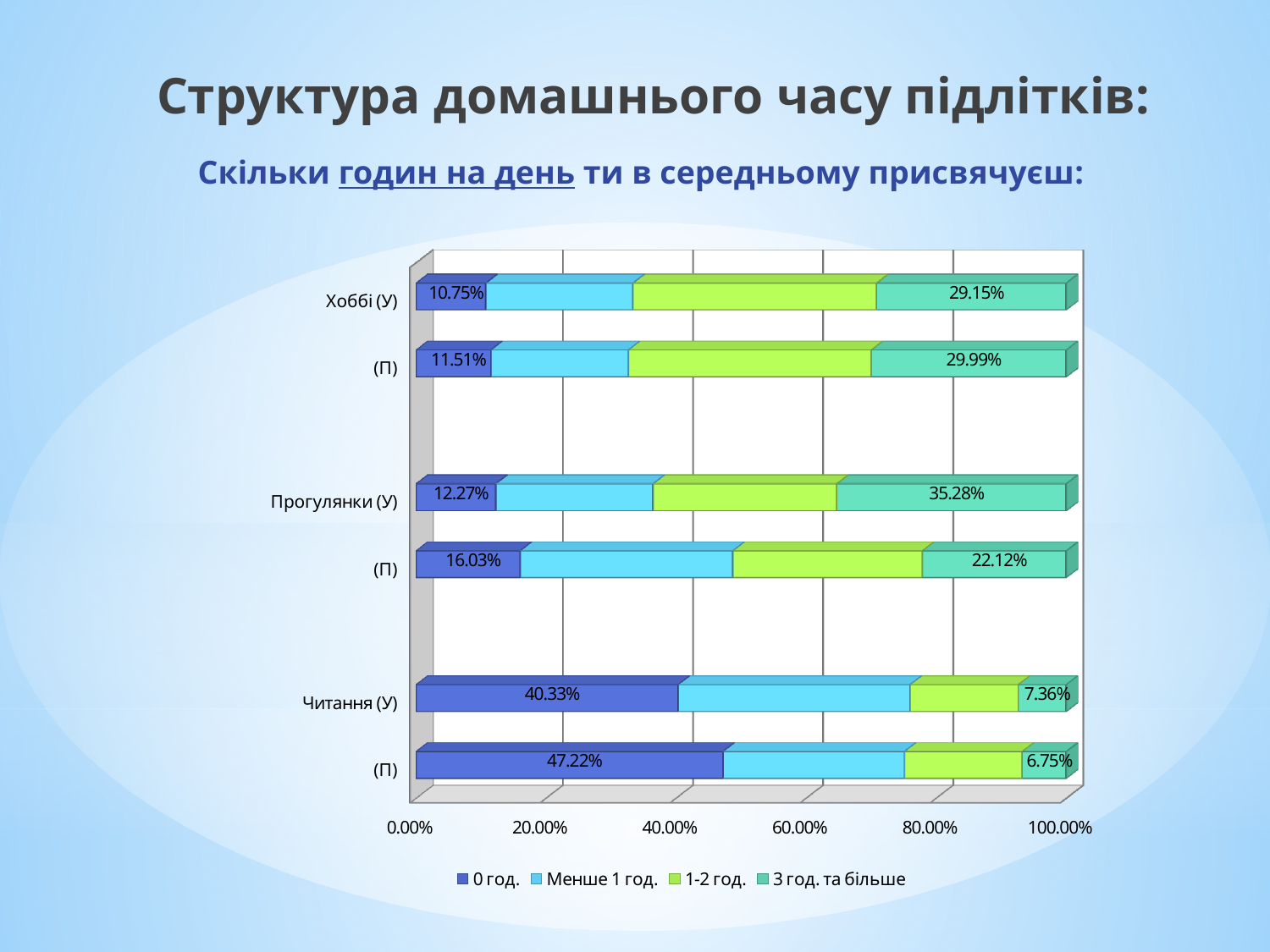
What is the value of the "3 год. та більше" segment for the (П) bar directly below Читання (У)? 6.75% What is the value of the "0 год." segment for Хоббі (У)? 10.75% Which category has the lowest labelled "3 год. та більше" value? (П) below Читання (У) How many series does the legend list? 4 How many category bars are plotted in the chart? 6 Which is larger: the "3 год. та більше" value for Прогулянки (У) or for the (П) bar directly below it? Прогулянки (У) Which series is shown in dark blue in the legend? 0 год. What is the value of the "3 год. та більше" segment for Прогулянки (У)? 35.28% What is the difference between the "0 год." values for the (П) bar below Читання (У) (47.22%) and Читання (У) (40.33%)? 6.89% What kind of chart is shown on the slide? stacked bar chart Which category has the highest labelled "0 год." value? (П) below Читання (У) What is the value of the "0 год." segment for Читання (У)? 40.33%